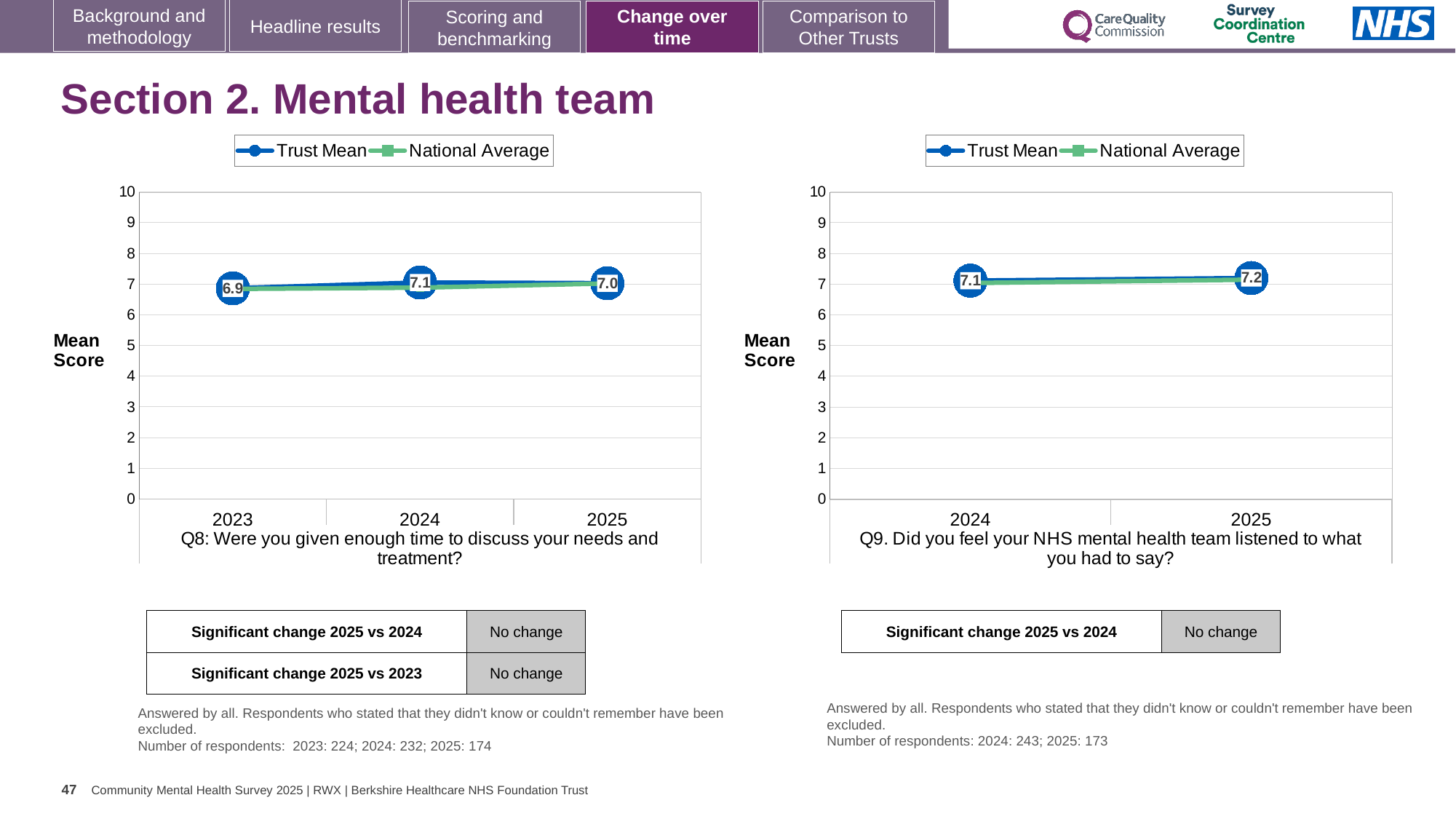
In the Q8 chart on the left, which year has the highest Trust Mean score? 2024 How many series does the legend of the Q9 chart on the right list? 2 In the Q8 chart on the left, what is the Trust Mean score for 2023? 6.9 In the Q9 chart on the right, is the Trust Mean score higher in 2024 or 2025? 2025 In the Q9 chart on the right, is the Trust Mean value for 2024 greater or less than 5? greater In the Q9 chart on the right, what is the Trust Mean score for 2025? 7.2 In the Q8 chart on the left, what is the Trust Mean score for 2025? 7.0 What type of chart is the Q8 chart on the left? Line chart In the Q8 chart on the left, what is the difference between the Trust Mean scores for 2024 and 2023? 0.2 In the Q8 chart on the left, which year has the lowest Trust Mean score? 2023 In the Q9 chart on the right, does the Trust Mean rise or fall from 2024 to 2025? Rise How many years are plotted on the x axis of the Q8 chart on the left? 3